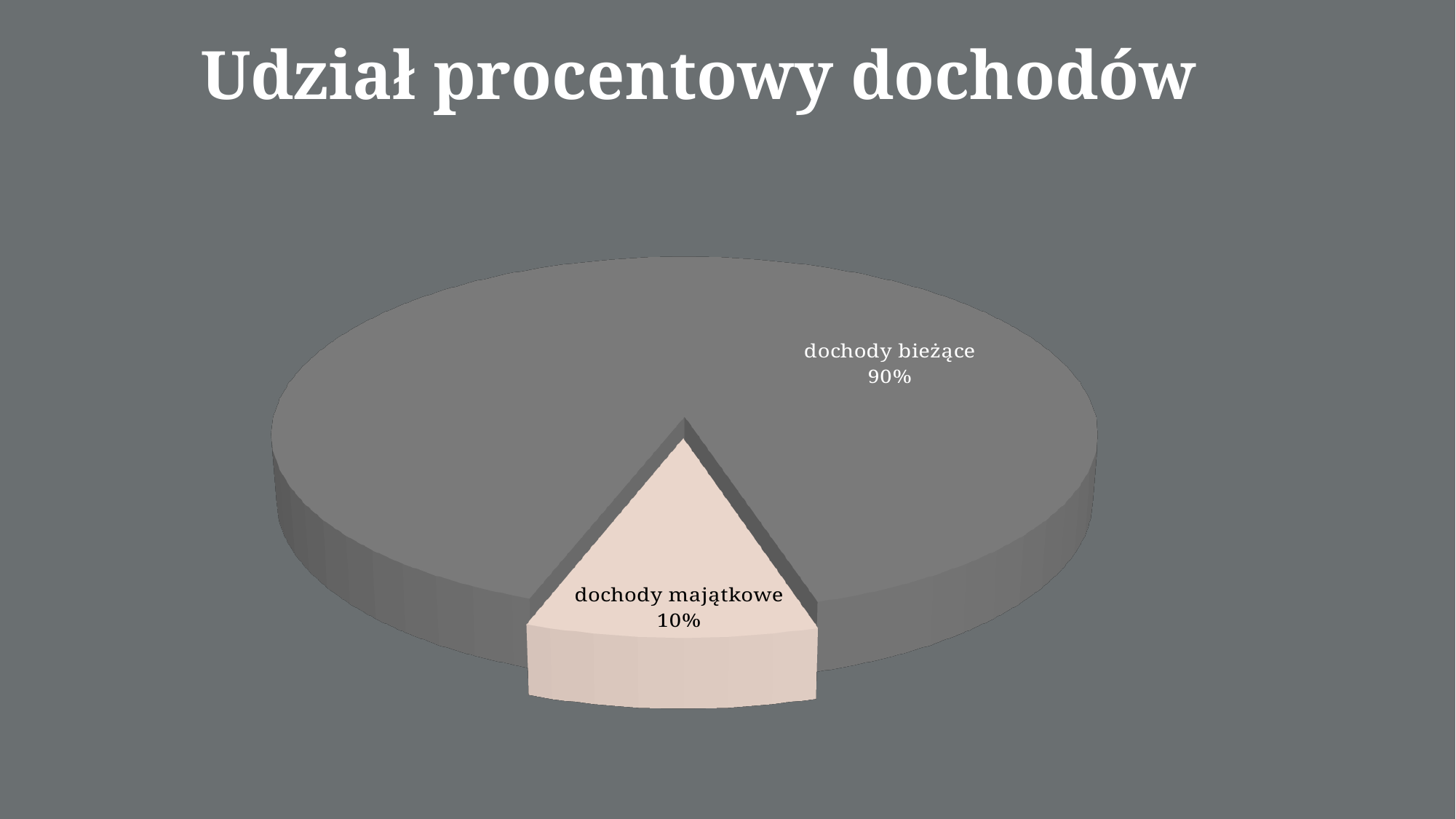
Which category has the smallest slice of the pie? dochody majątkowe What share of the pie does 'dochody majątkowe' represent? 10% Which slice is pulled out (exploded) from the pie? dochody majątkowe Which is larger, 'dochody bieżące' or 'dochody majątkowe'? dochody bieżące How many slices does the pie chart have? 2 What is the difference in percentage points between 'dochody bieżące' and 'dochody majątkowe'? 80 What kind of chart is shown on the slide? pie chart What share of the pie does 'dochody bieżące' represent? 90% What is the title of the slide? Udział procentowy dochodów Which category has the largest slice of the pie? dochody bieżące